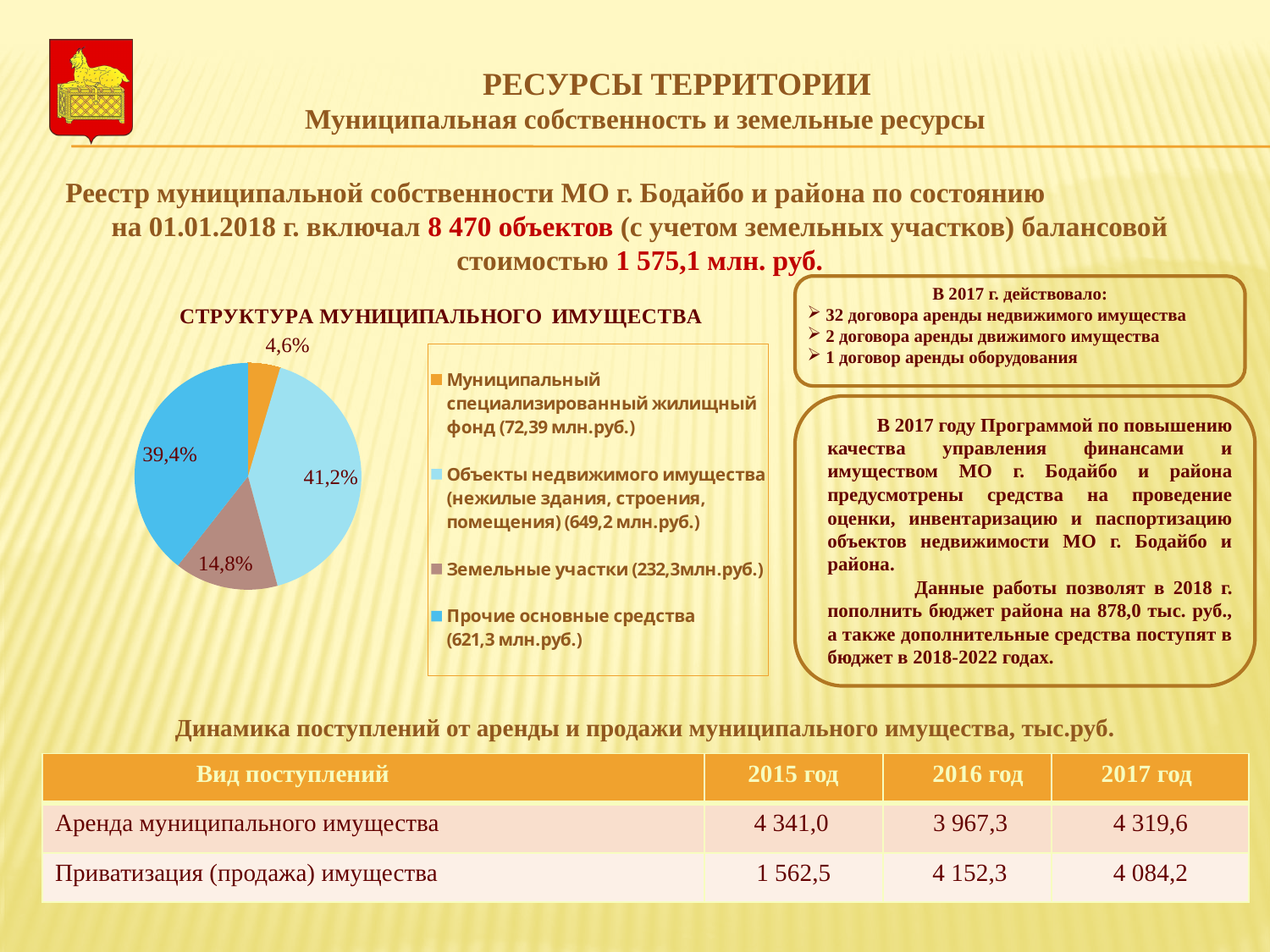
Which category has the smallest slice in the pie chart? Муниципальный специализированный жилищный фонд What colour is the «Земельные участки» slice in the pie chart? Brown What share of the pie chart is «Объекты недвижимого имущества (нежилые здания, строения, помещения)»? 41,2% What share of the pie chart is «Муниципальный специализированный жилищный фонд»? 4,6% By how many percentage points does the share of «Объекты недвижимого имущества» exceed the share of «Земельные участки» in the pie chart? 26,4 What kind of chart is shown under the heading «СТРУКТУРА МУНИЦИПАЛЬНОГО ИМУЩЕСТВА»? Pie chart What share of the pie chart is «Прочие основные средства»? 39,4% Which category has the largest slice in the pie chart? Объекты недвижимого имущества (нежилые здания, строения, помещения) How many slices does the pie chart «СТРУКТУРА МУНИЦИПАЛЬНОГО ИМУЩЕСТВА» have? 4 According to the legend of the pie chart, what is the value in млн.руб. given for «Земельные участки»? 232,3 млн.руб. Which slice is larger in the pie chart: «Земельные участки» or «Прочие основные средства»? Прочие основные средства